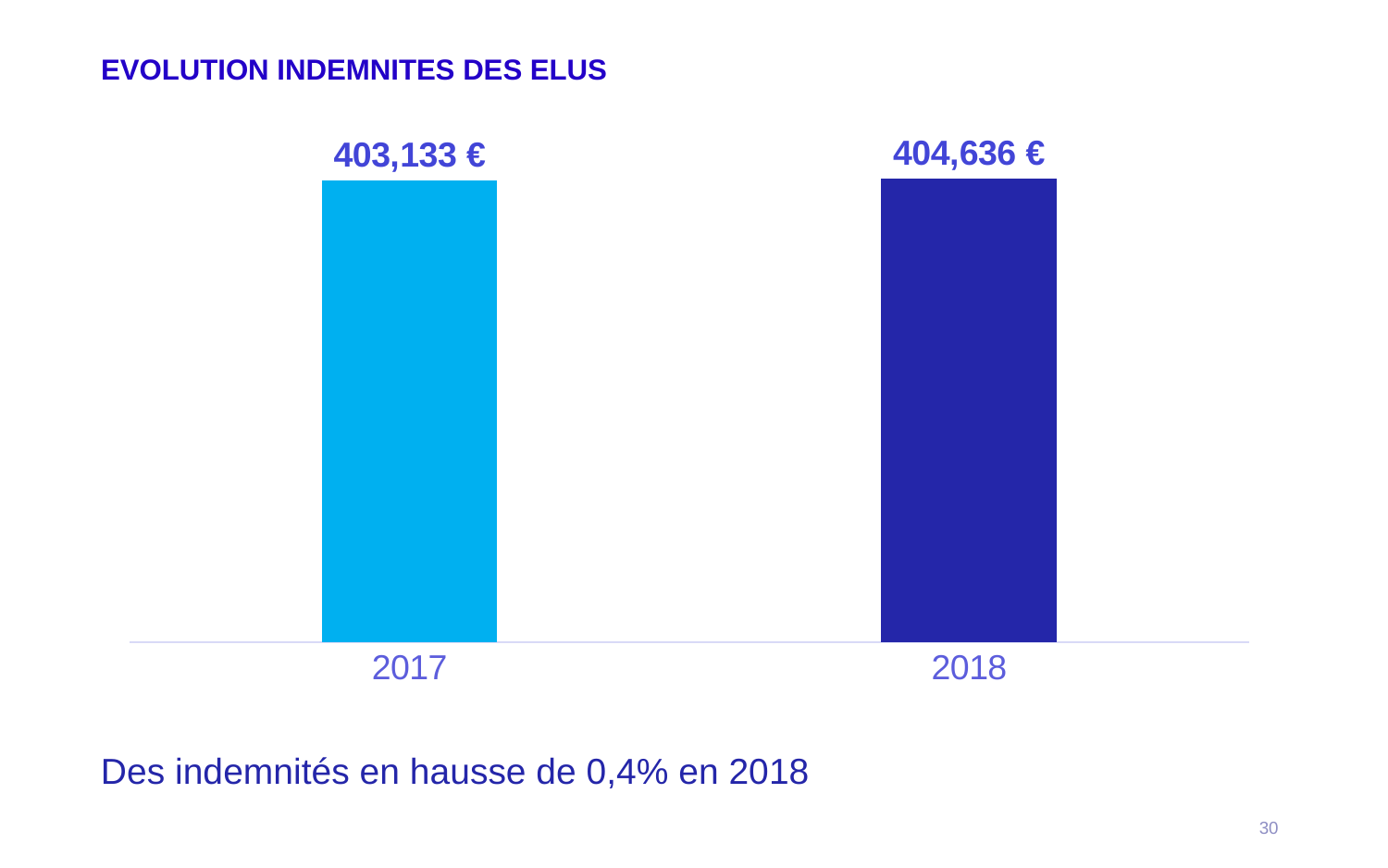
Do the values rise or fall from 2017 to 2018? rise How many bars are shown in the chart? 2 What is the value for 2017? 403,133 € Is the value for 2018 larger or smaller than the value for 2017? larger Which year has the higher value? 2018 Which year has the lower value? 2017 What is the title of the chart? EVOLUTION INDEMNITES DES ELUS What is the value for 2018? 404,636 € What kind of chart is shown on the slide? bar chart What is the difference between the 2018 and 2017 values? 1,503 € According to the text below the chart, by what percentage did the indemnities increase in 2018? 0,4%